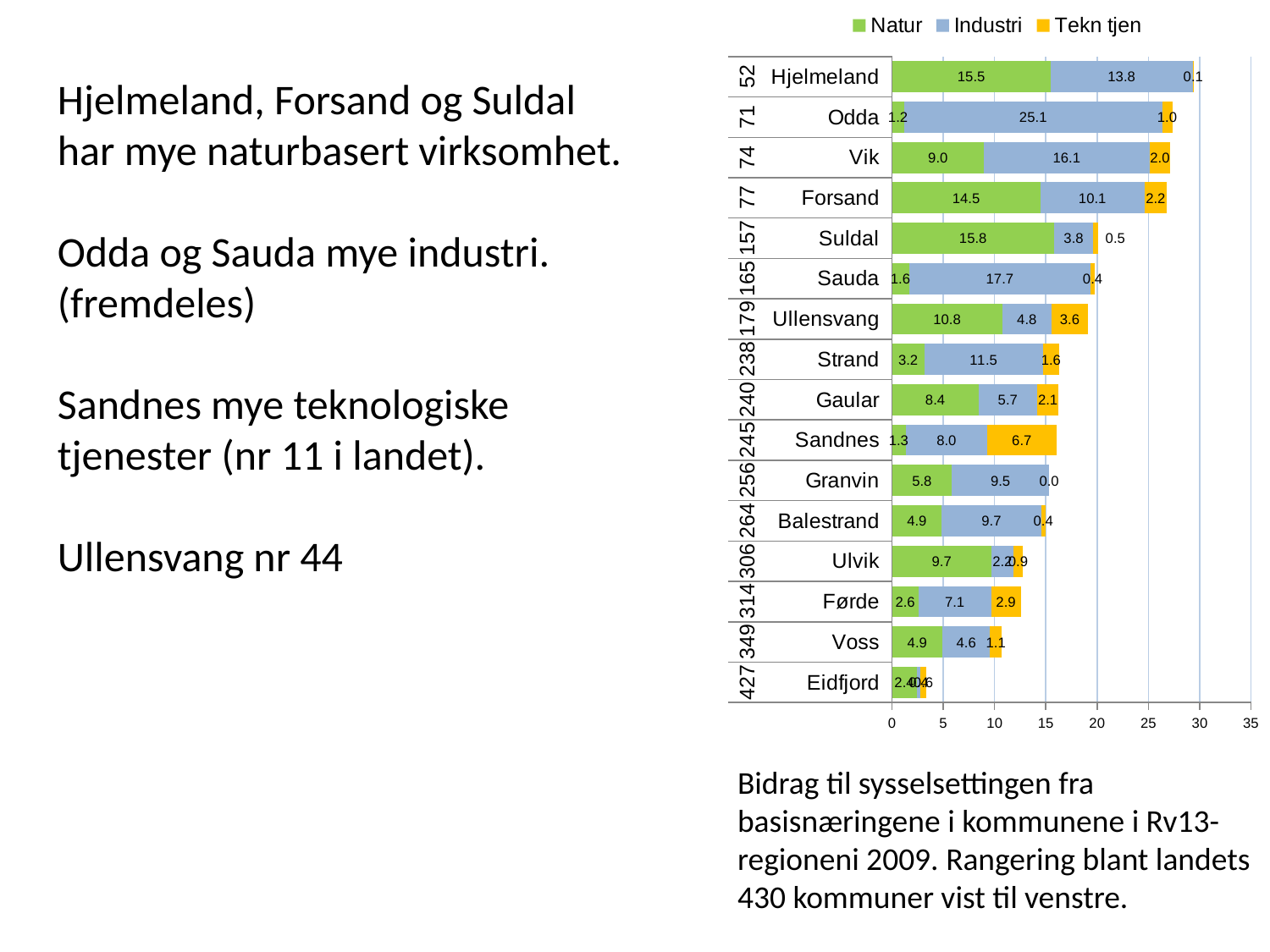
What kind of chart is shown on the slide? Stacked bar chart How many series does the legend list? 3 Which municipality has the highest Tekn tjen value? Sandnes What is the total of the stacked bar for Hjelmeland? 29.4 Which is larger, the Industri value for Vik or the Industri value for Forsand? Vik Is the total bar length for Odda greater or less than 25? greater What is the Natur value for Hjelmeland? 15.5 What is the Tekn tjen value for Sandnes? 6.7 How many municipalities are shown in the chart? 16 What is the difference between the Natur and Industri values for Hjelmeland? 1.7 Which municipality has the highest Industri value? Odda What is the Industri value for Odda? 25.1